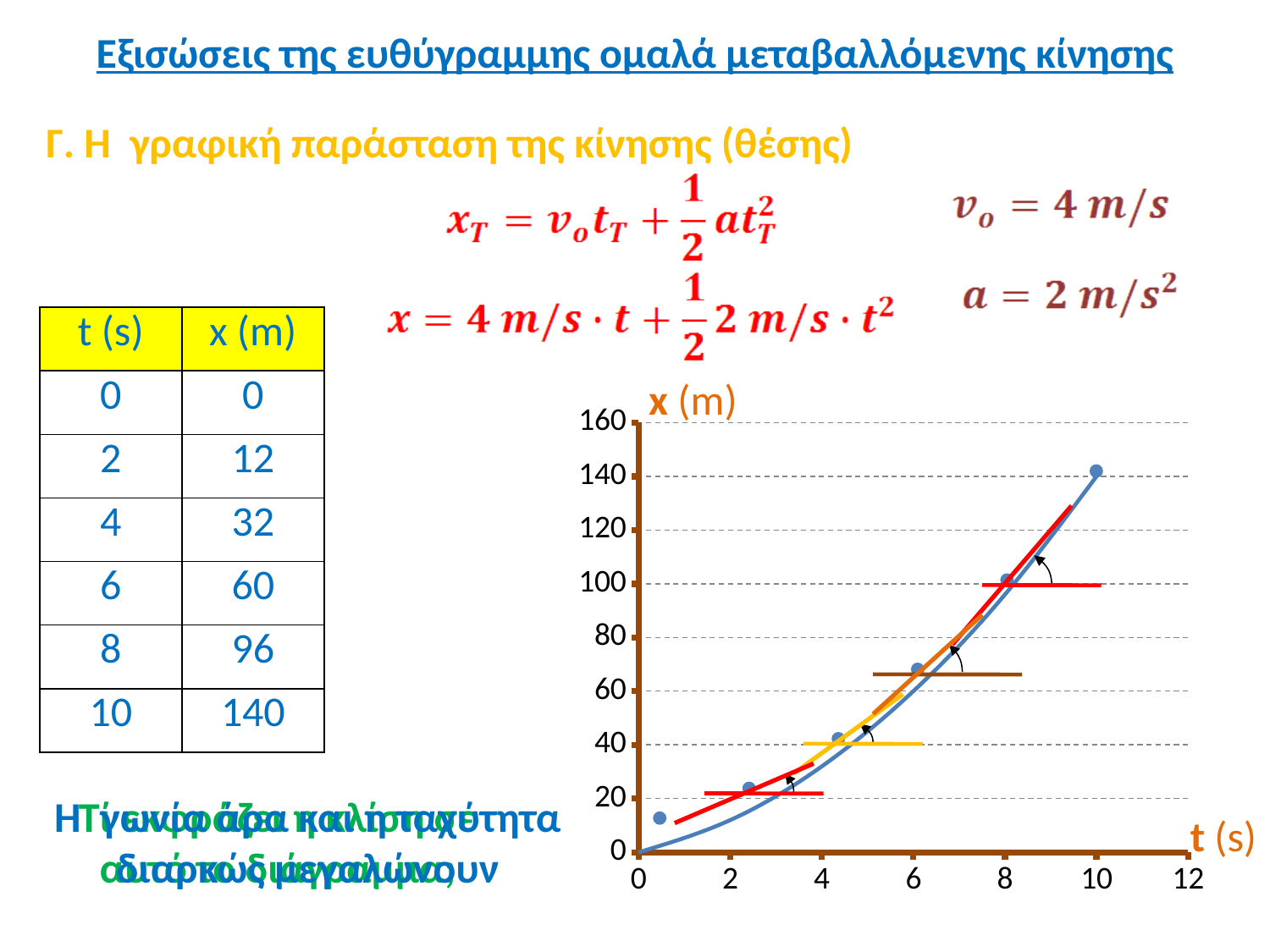
What is the label of the horizontal axis of the chart? t (s) What is the highest tick value shown on the vertical axis of the chart? 160 What kind of chart is shown on the slide? line chart Is the plotted value at t = 4 greater or less than 60? less Is the plotted value at t = 6 greater or less than 40? greater Is the plotted value at t = 2 greater or less than 40? less At which value of t is the plotted x value highest? 10 Do the plotted x values rise or fall as t increases along the x axis? rise Which is larger, the plotted value at t = 10 or at t = 8? t = 10